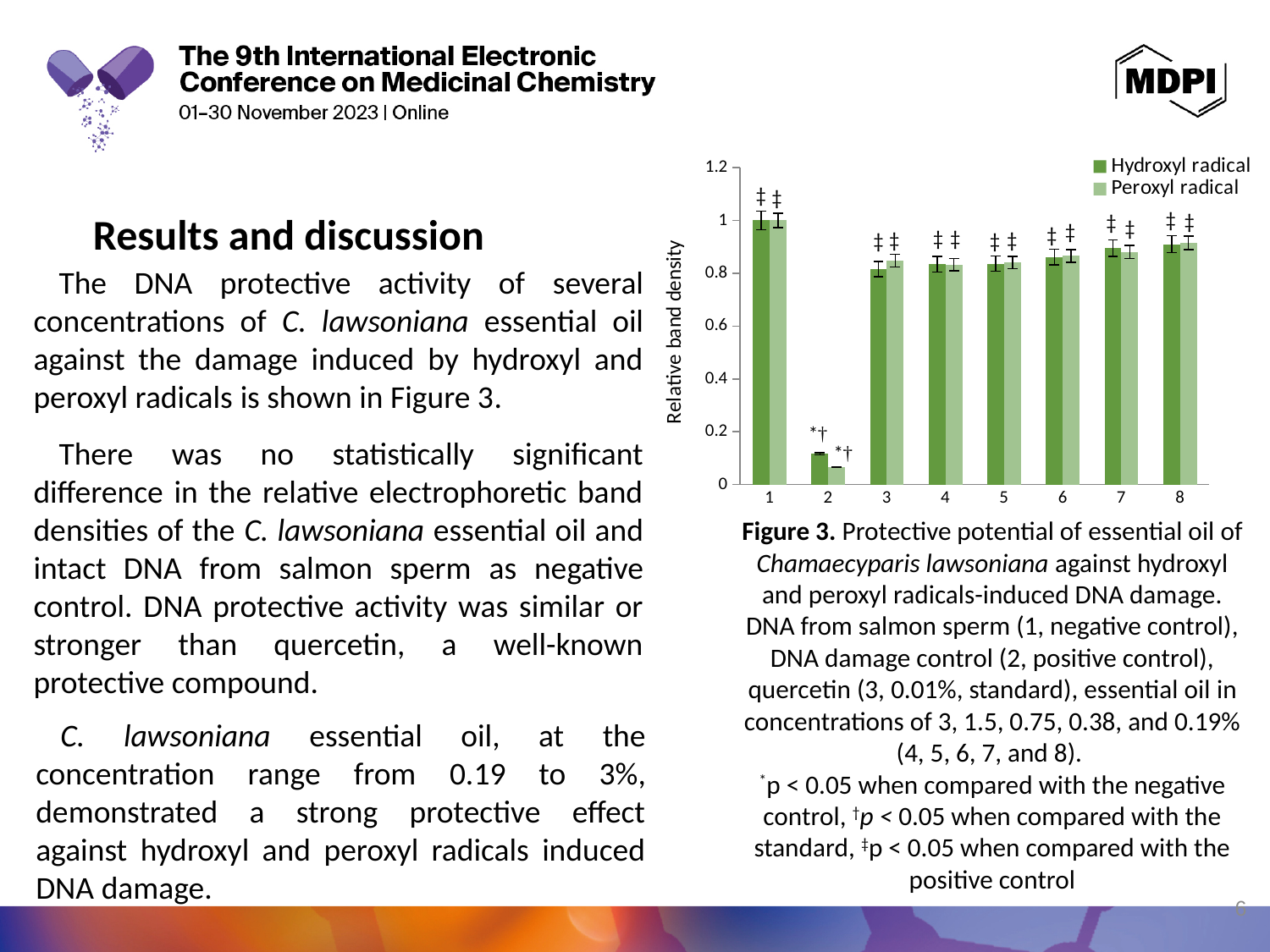
How many categories are shown on the x axis of the chart? 8 Is the Hydroxyl radical value for category 2 greater or less than 0.2? less What is the label of the y axis of the chart? Relative band density What kind of chart is shown on the slide? bar chart Which category has the lowest Hydroxyl radical value? 2 Which category has the lowest Peroxyl radical value? 2 Is the Hydroxyl radical value for category 5 greater or less than 1? less Which series is shown in the lighter green colour in the chart? Peroxyl radical Which category has the highest Hydroxyl radical value? 1 Which is larger, the Hydroxyl radical value for category 1 or for category 2? category 1 Is the Peroxyl radical value for category 8 greater or less than 0.8? greater How many series does the chart legend list? 2